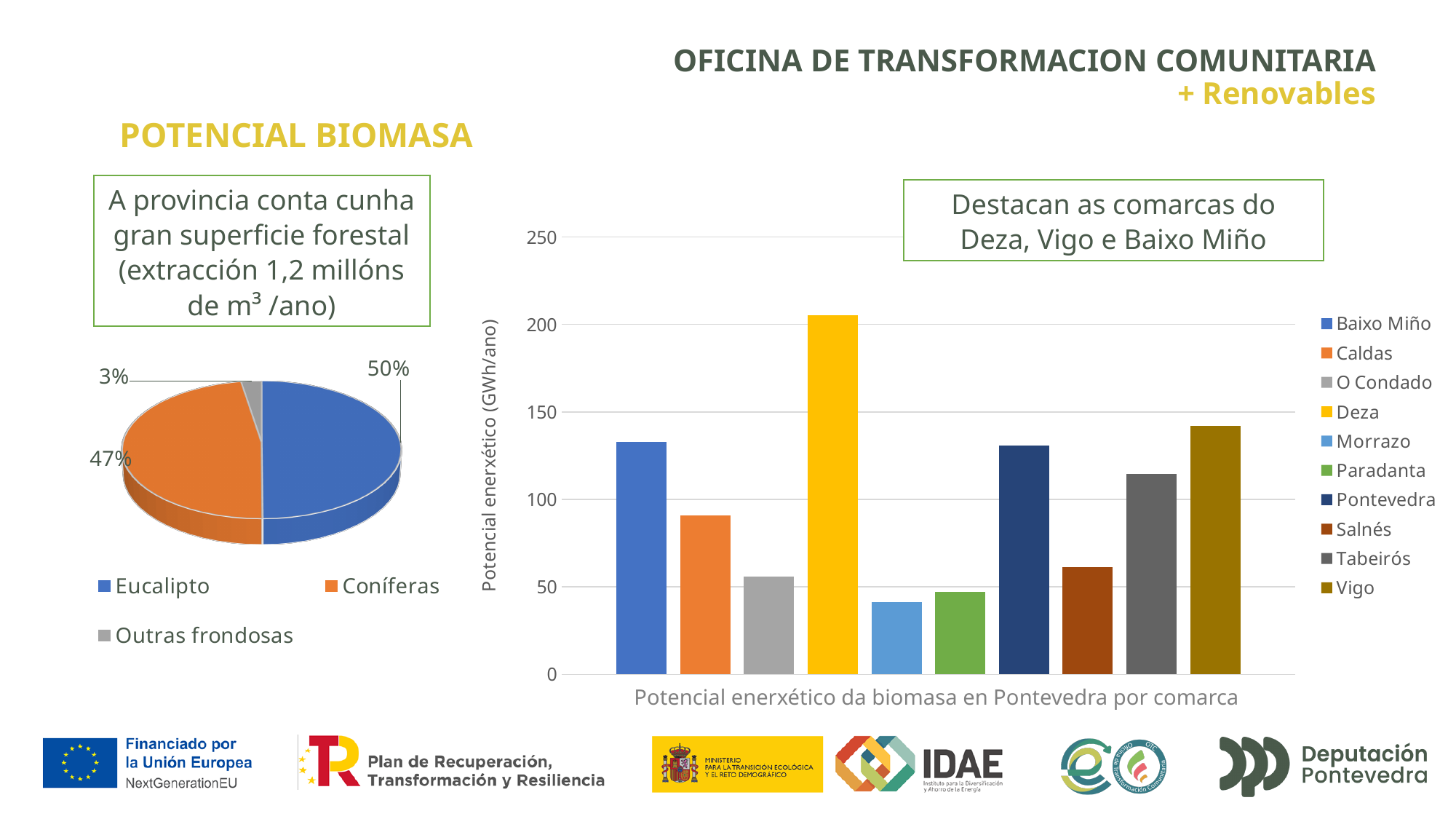
What kind of chart is the chart on the left of the slide? Pie chart In the bar chart 'Potencial enerxético da biomasa en Pontevedra por comarca', which comarca has the highest value? Deza In the bar chart 'Potencial enerxético da biomasa en Pontevedra por comarca', is the value for Tabeirós greater or less than 100? greater In the bar chart 'Potencial enerxético da biomasa en Pontevedra por comarca', which is larger, the value for Deza or the value for Baixo Miño? Deza In the pie chart, which category has the smallest share? Outras frondosas In the pie chart, what share does Eucalipto have? 50% In the pie chart, what is the difference in percentage points between Eucalipto and Coníferas? 3 In the pie chart, what share does Outras frondosas have? 3% In the bar chart 'Potencial enerxético da biomasa en Pontevedra por comarca', is the value for Morrazo greater or less than 50? less How many comarcas are shown in the bar chart 'Potencial enerxético da biomasa en Pontevedra por comarca'? 10 In the bar chart 'Potencial enerxético da biomasa en Pontevedra por comarca', is the value for Deza greater or less than 200? greater In the pie chart, which category has the largest share? Eucalipto